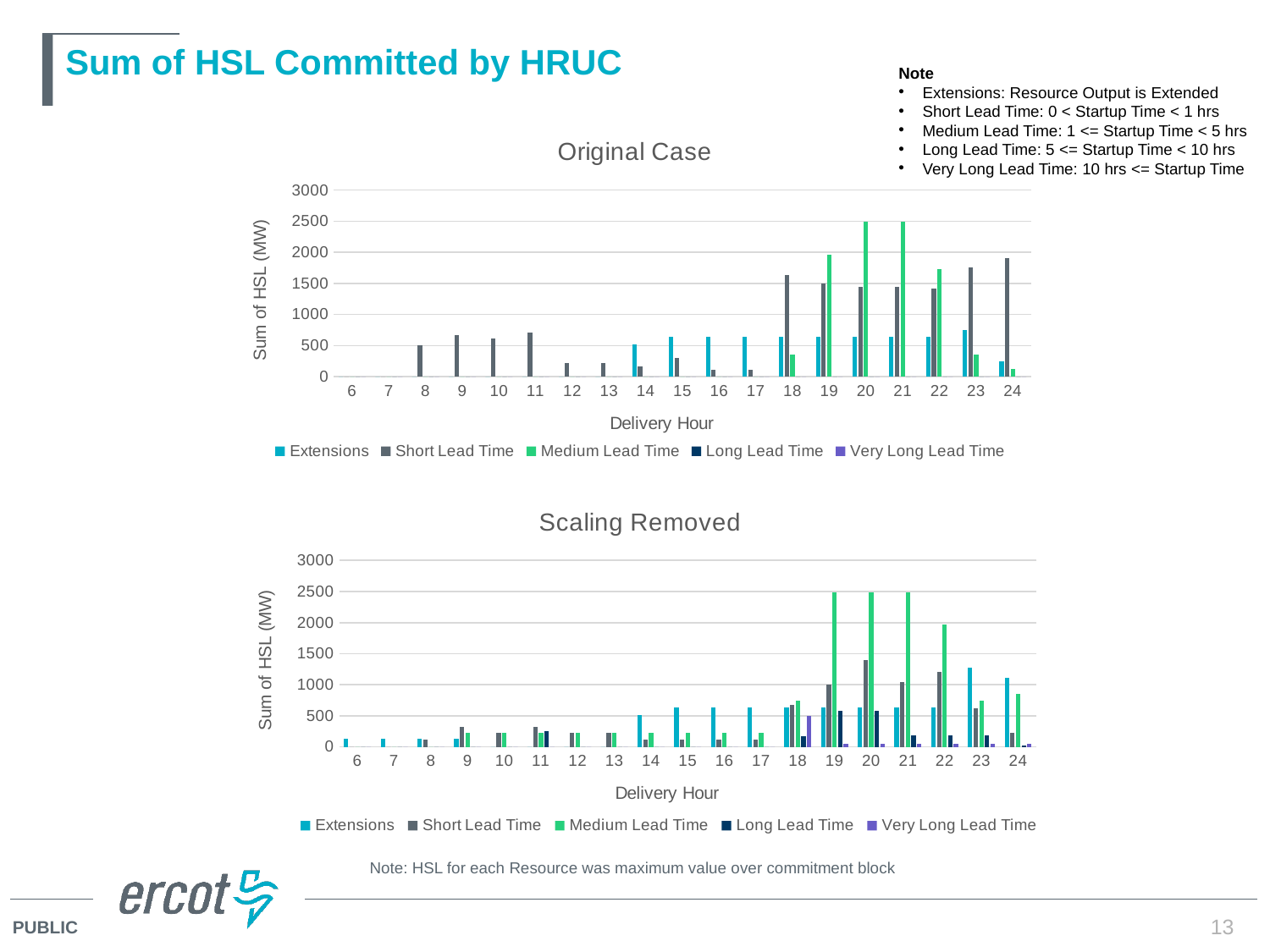
In the Original Case chart, is the Short Lead Time value at delivery hour 8 greater or less than 1000? less What is the y-axis title of the Scaling Removed chart? Sum of HSL (MW) In the Scaling Removed chart, at delivery hour 20, which is larger: Medium Lead Time or Short Lead Time? Medium Lead Time How many series does the legend of the Scaling Removed chart list? 5 What type of chart is the Scaling Removed chart? bar chart What type of chart is the Original Case chart? bar chart In the Original Case chart, at delivery hour 19, which is larger: Medium Lead Time or Short Lead Time? Medium Lead Time In the Original Case chart, at which delivery hour is the Short Lead Time value highest? 24 How many delivery hours are shown on the x axis of the Original Case chart? 19 In the Scaling Removed chart, is the Medium Lead Time value at delivery hour 22 greater or less than 1500? greater How many series does the legend of the Original Case chart list? 5 In the Original Case chart, is the Medium Lead Time value at delivery hour 20 greater or less than 2000? greater